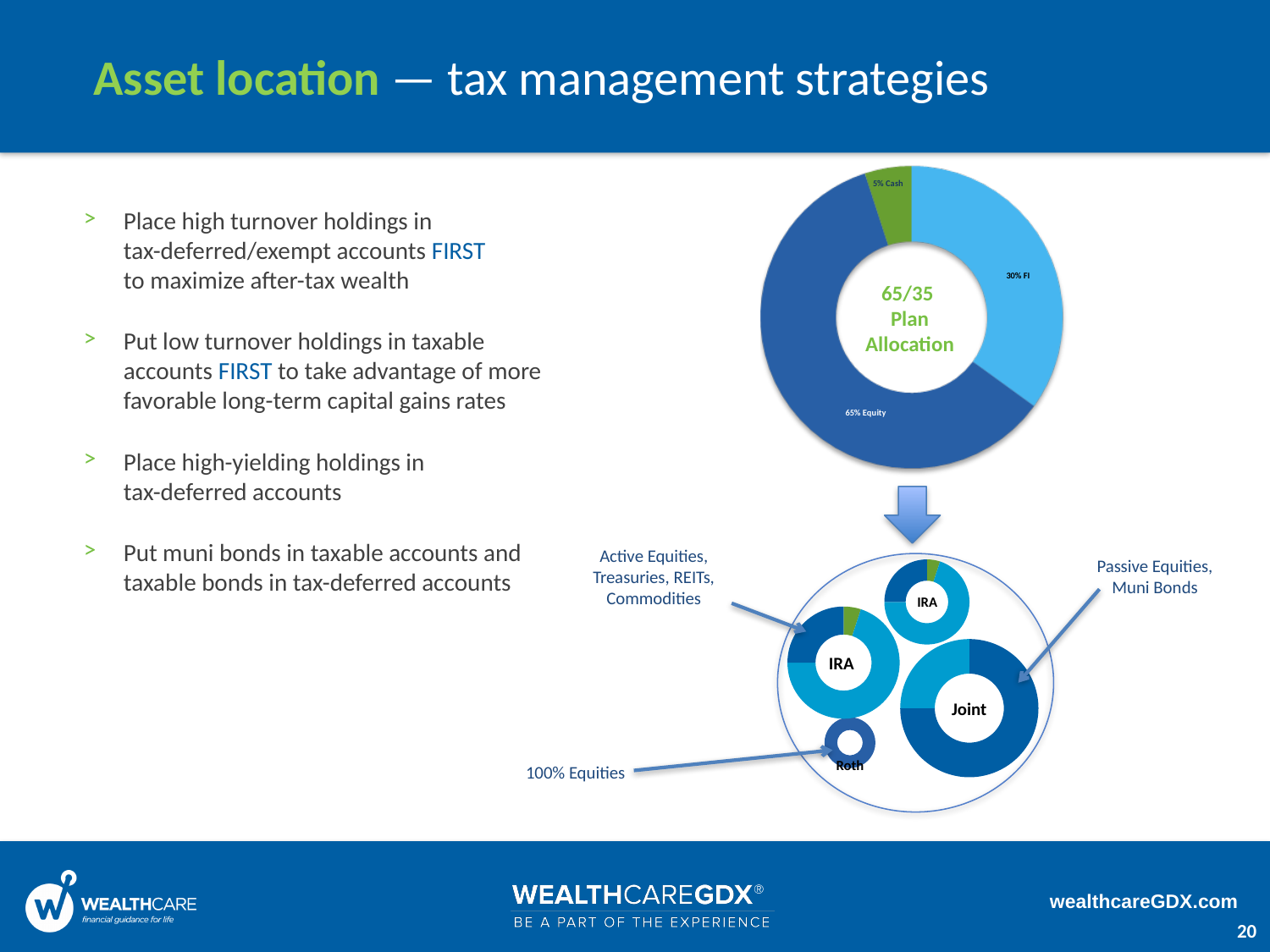
In the large donut chart at the top right, how many percentage points larger is the Equity share than the FI share? 35 What kind of chart is the large chart at the top right of the slide? donut chart In the large donut chart at the top right, which is larger, the FI share or the Cash share? FI In the large donut chart at the top right, what share is labelled for Cash? 5% How many slices does the large donut chart at the top right have? 3 In the large donut chart at the top right, which category has the largest share? Equity In the large donut chart at the top right, what share is labelled for Equity? 65% In the large donut chart at the top right, what do the Equity, FI and Cash shares add up to? 100% In the large donut chart at the top right, which category has the smallest share? Cash In the large donut chart at the top right, what share is labelled for FI? 30% How many small donut charts are shown inside the circle at the bottom right of the slide? 4 What text is shown in the centre of the large donut chart at the top right? 65/35 Plan Allocation